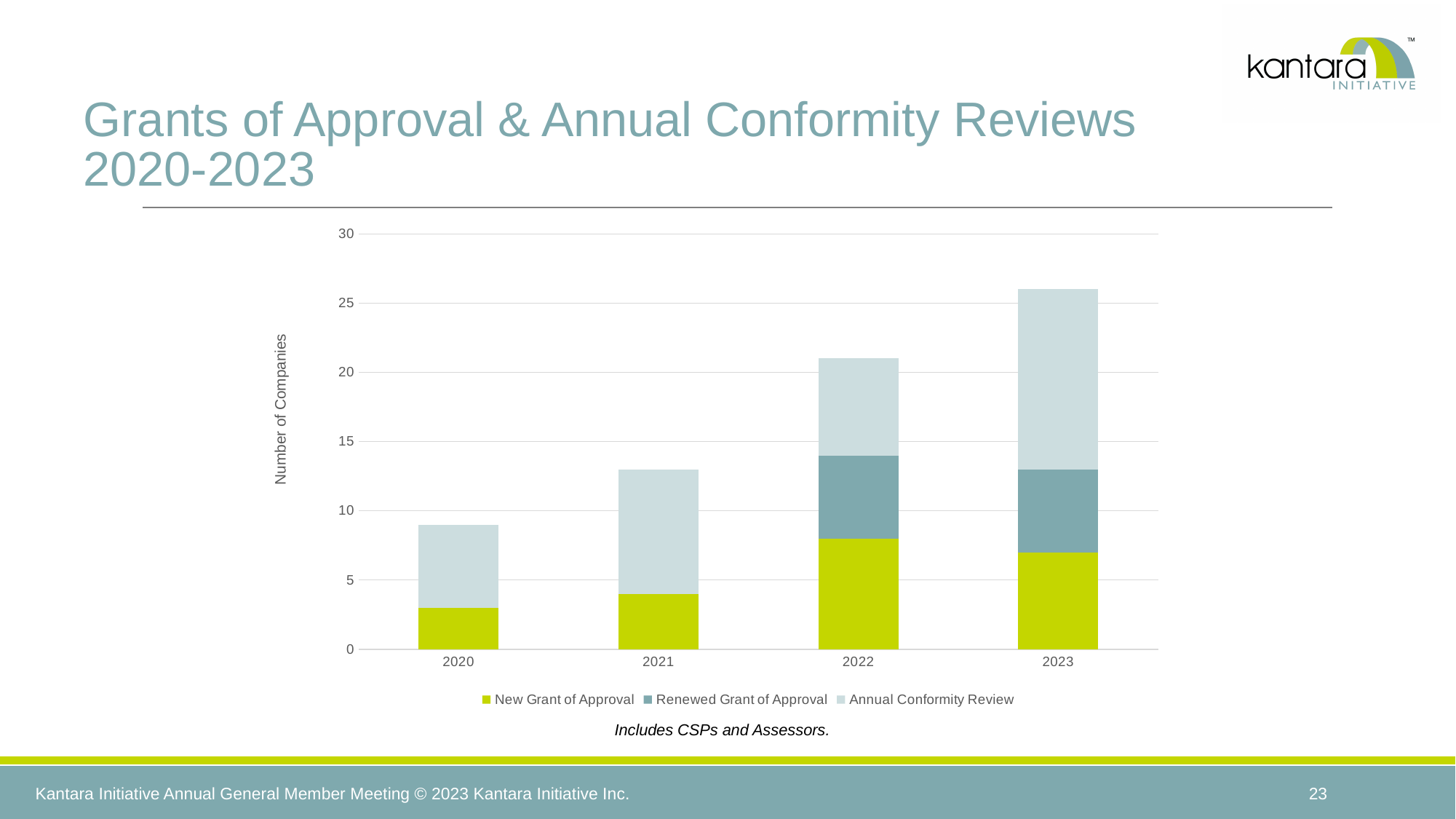
What is the label on the chart's vertical axis? Number of Companies Which year has the larger total stacked bar, 2021 or 2022? 2022 Is the total stacked bar for 2023 greater or less than 20? greater Is the total stacked bar for 2020 greater or less than 10? less How many years are shown on the x axis of the chart? 4 Is the total stacked bar for 2021 greater or less than 10? greater Which year has the shortest stacked bar (lowest total number of companies)? 2020 How many series does the chart's legend list? 3 Which year has the tallest stacked bar (highest total number of companies)? 2023 Do the total stacked bar heights rise or fall from 2020 to 2023? rise What kind of chart is shown on the slide? Stacked bar chart